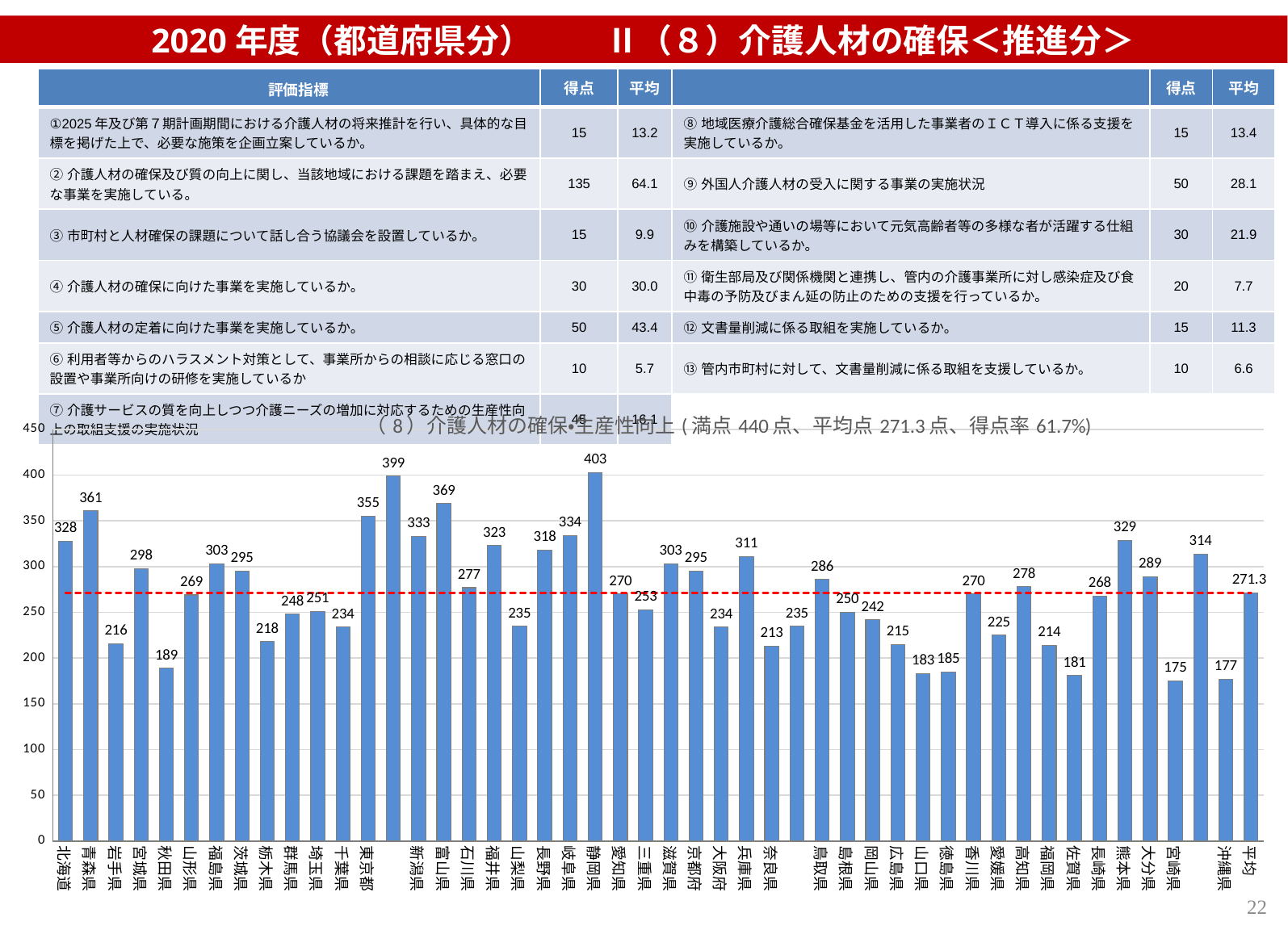
What is the difference between the values for 青森県 and 岩手県? 145 Which has a larger value, 東京都 or 富山県? 富山県 Which prefecture has the highest value in the bar chart? 静岡県 What is the value for 静岡県 in the bar chart? 403 What is the value for 北海道 in the bar chart? 328 Is the value for 秋田県 greater or less than 200? less Which prefecture has the lowest value in the bar chart? 宮崎県 What kind of chart is shown on the slide? bar chart What is the difference between the values for 熊本県 and 大分県? 40 According to the chart title, what is the 得点率 (score rate)? 61.7% What is the value for 兵庫県 in the bar chart? 311 What is the value shown for 平均 at the right end of the bar chart? 271.3